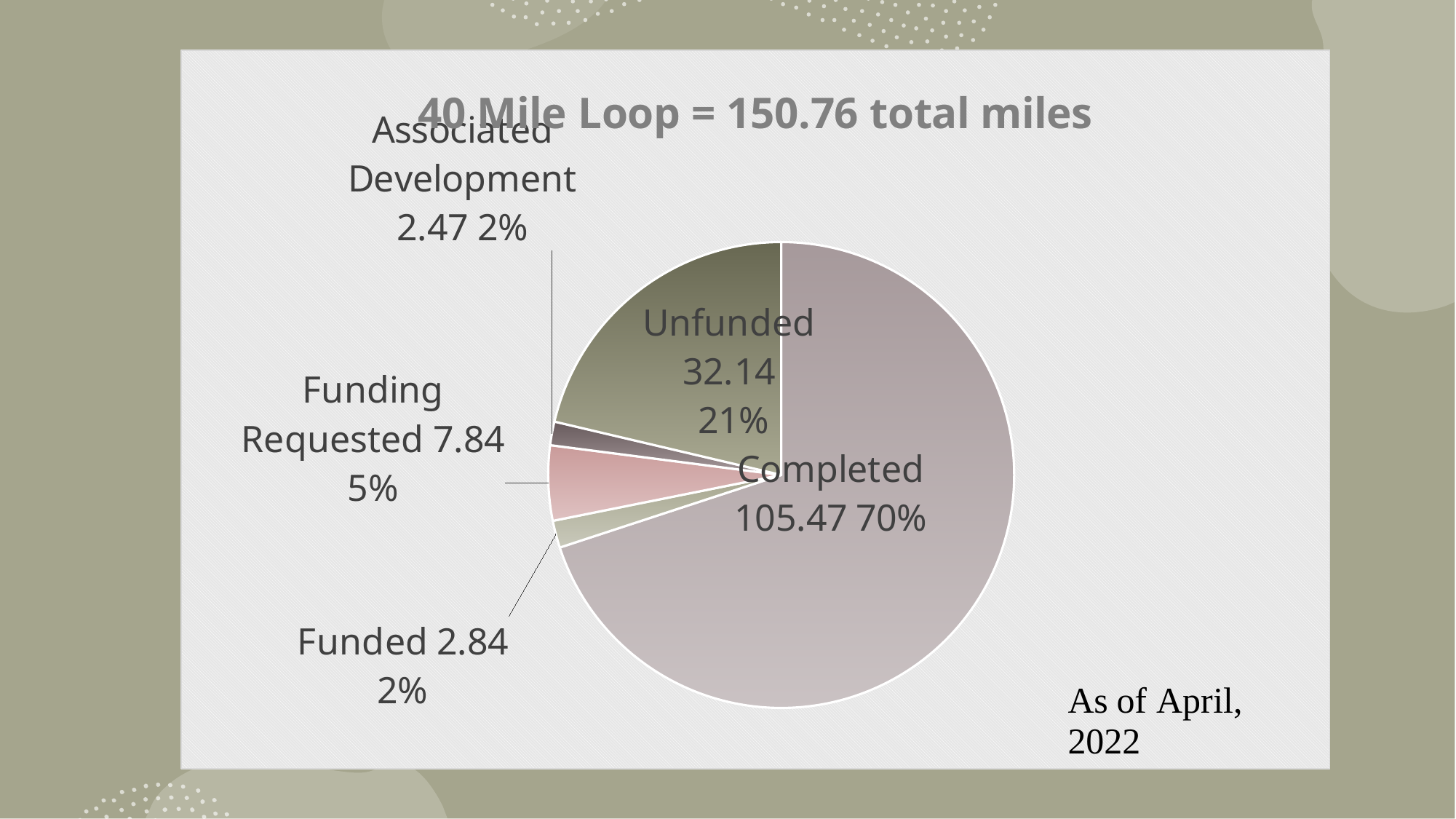
Which is larger, Unfunded or Funding Requested? Unfunded Which category has the largest slice? Completed How many miles are labelled as Funding Requested? 7.84 What type of chart is shown on the slide? pie chart What is the difference in miles between Completed and Unfunded? 73.33 What is the title of the chart? 40 Mile Loop = 150.76 total miles What percentage of the pie is Funded? 2% How many slices does the pie chart have? 5 Which category has the smallest value in miles? Associated Development What percentage of the pie is Unfunded? 21% How many miles are labelled as Completed? 105.47 What share of the pie does the Completed slice represent? 70%